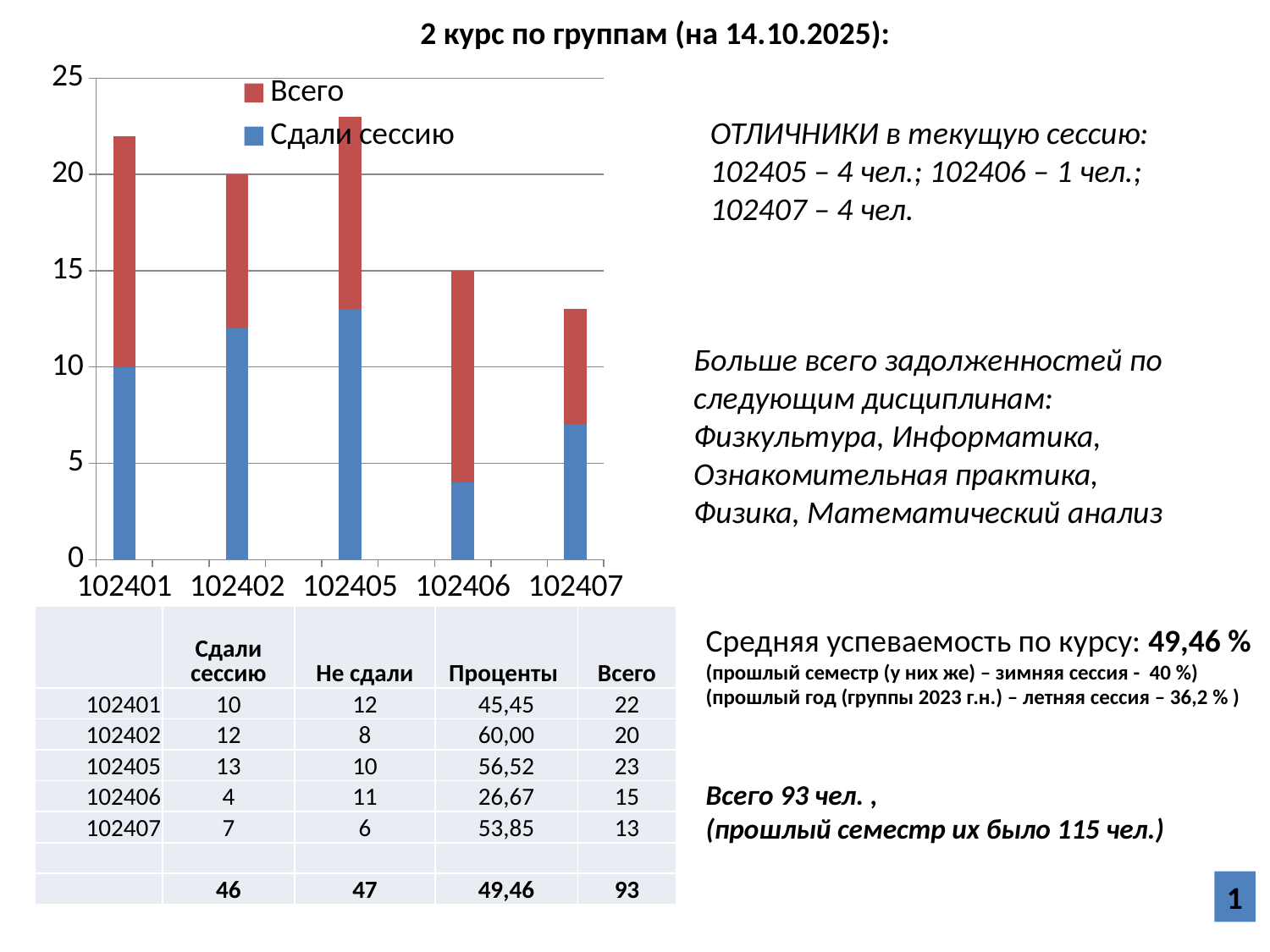
How many groups (categories) are shown on the x axis of the chart? 5 Which group has the shortest stacked bar in the chart? 102407 What kind of chart is shown on the slide? stacked bar chart What is the total height of the stacked bar for group 102402? 20 Which group has the smallest 'Сдали сессию' (blue) value? 102406 Is the 'Сдали сессию' value for group 102405 greater or less than 10? greater What is the total height of the stacked bar for group 102406? 15 What is the value of 'Сдали сессию' for group 102401? 10 Which group has the tallest stacked bar in the chart? 102405 Which is larger: the 'Сдали сессию' value for 102402 or for 102407? 102402 How many series does the chart legend list? 2 What are the two legend entries of the chart? Всего, Сдали сессию